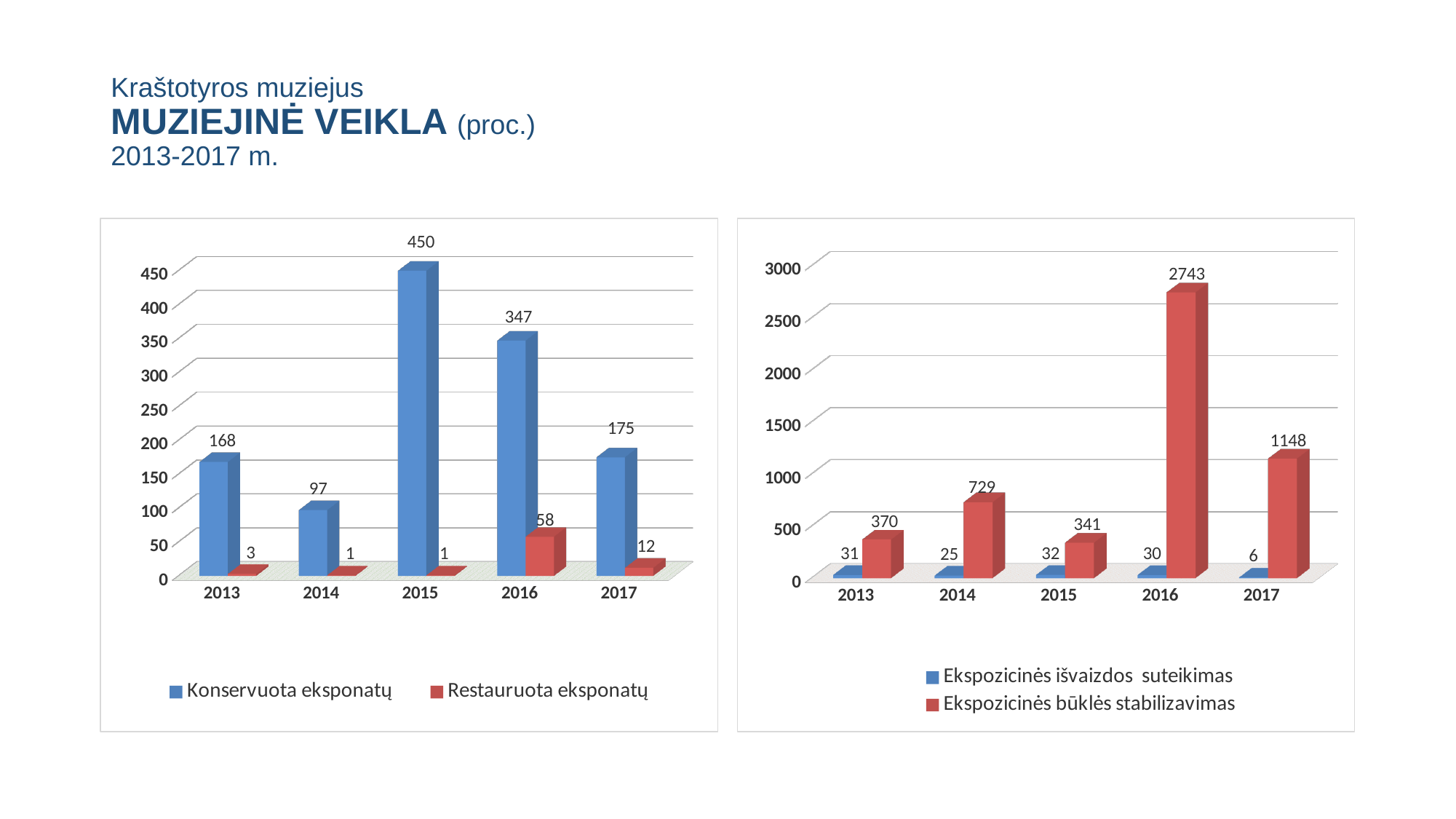
In the left chart, what is the value for Restauruota eksponatų in 2016? 58 In the left chart, what is the value for Konservuota eksponatų in 2015? 450 In the left chart, what is the difference between Konservuota eksponatų in 2015 and in 2016? 103 In the left chart, how many series does the legend list? 2 In the right chart, what is the difference between Ekspozicinės būklės stabilizavimas in 2016 and in 2017? 1595 In the right chart, what is the value for Ekspozicinės būklės stabilizavimas in 2016? 2743 In the right chart, which year has the highest value for Ekspozicinės būklės stabilizavimas? 2016 In the left chart, which year has the lowest value for Konservuota eksponatų? 2014 In the right chart, what is the value for Ekspozicinės išvaizdos suteikimas in 2017? 6 In the right chart, how many years are shown on the x axis? 5 In the left chart, what kind of chart is shown? Bar chart In the right chart, which is larger: Ekspozicinės būklės stabilizavimas in 2014 or in 2017? 2017